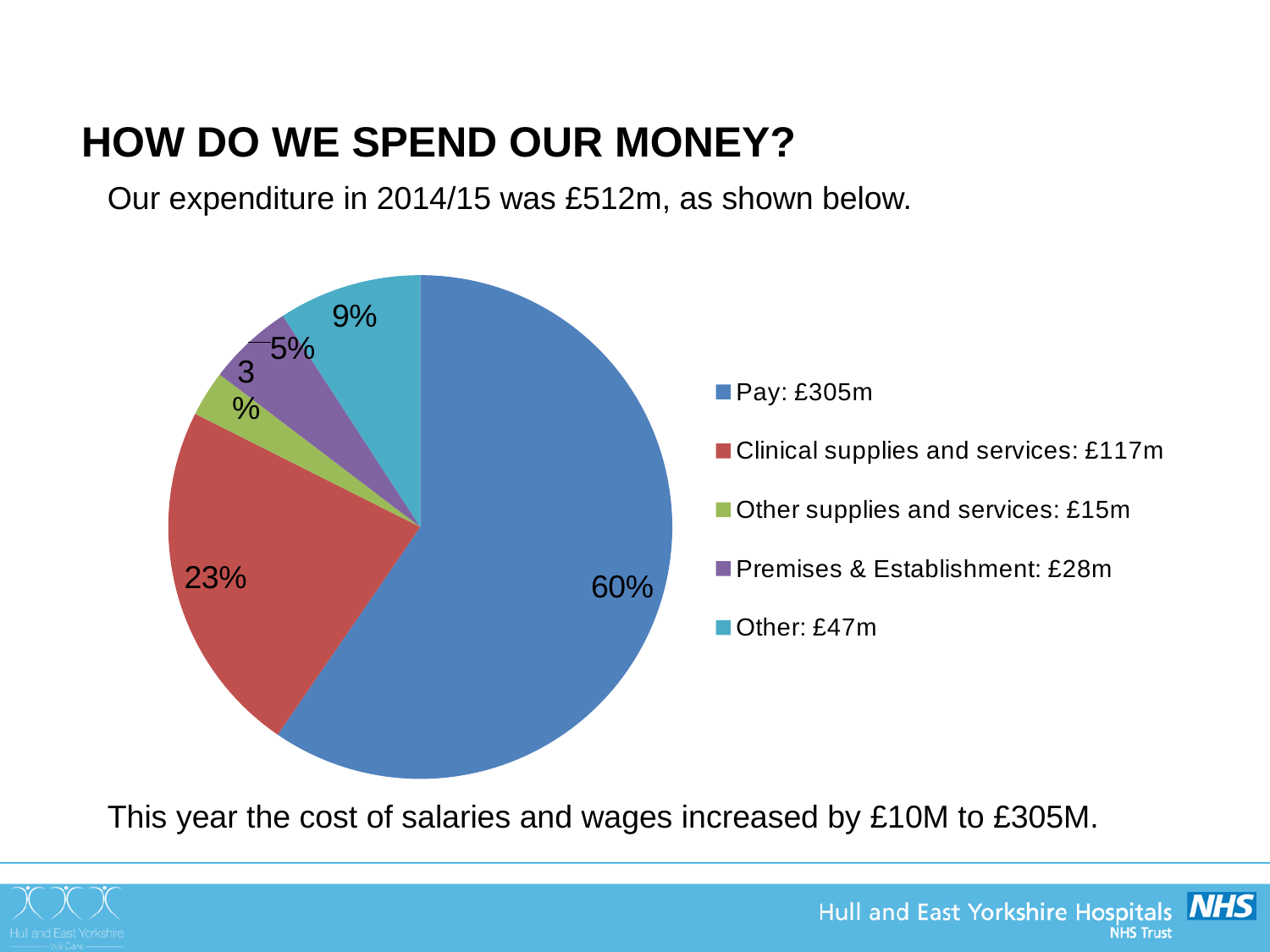
What is the difference in percentage points between the Pay slice and the Clinical supplies and services slice? 37 Which category has the largest slice of the pie? Pay What percentage of expenditure does the Pay slice represent? 60% Which category has the smallest slice of the pie? Other supplies and services What percentage of expenditure does the Premises & Establishment slice represent? 5% What kind of chart is shown on the slide? pie chart Which is larger, the Other slice or the Premises & Establishment slice? Other According to the legend, what amount is shown for Clinical supplies and services? £117m What percentage of expenditure does the Other slice represent? 9% How many categories does the pie chart show? 5 What colour is the Pay slice in the pie chart? blue